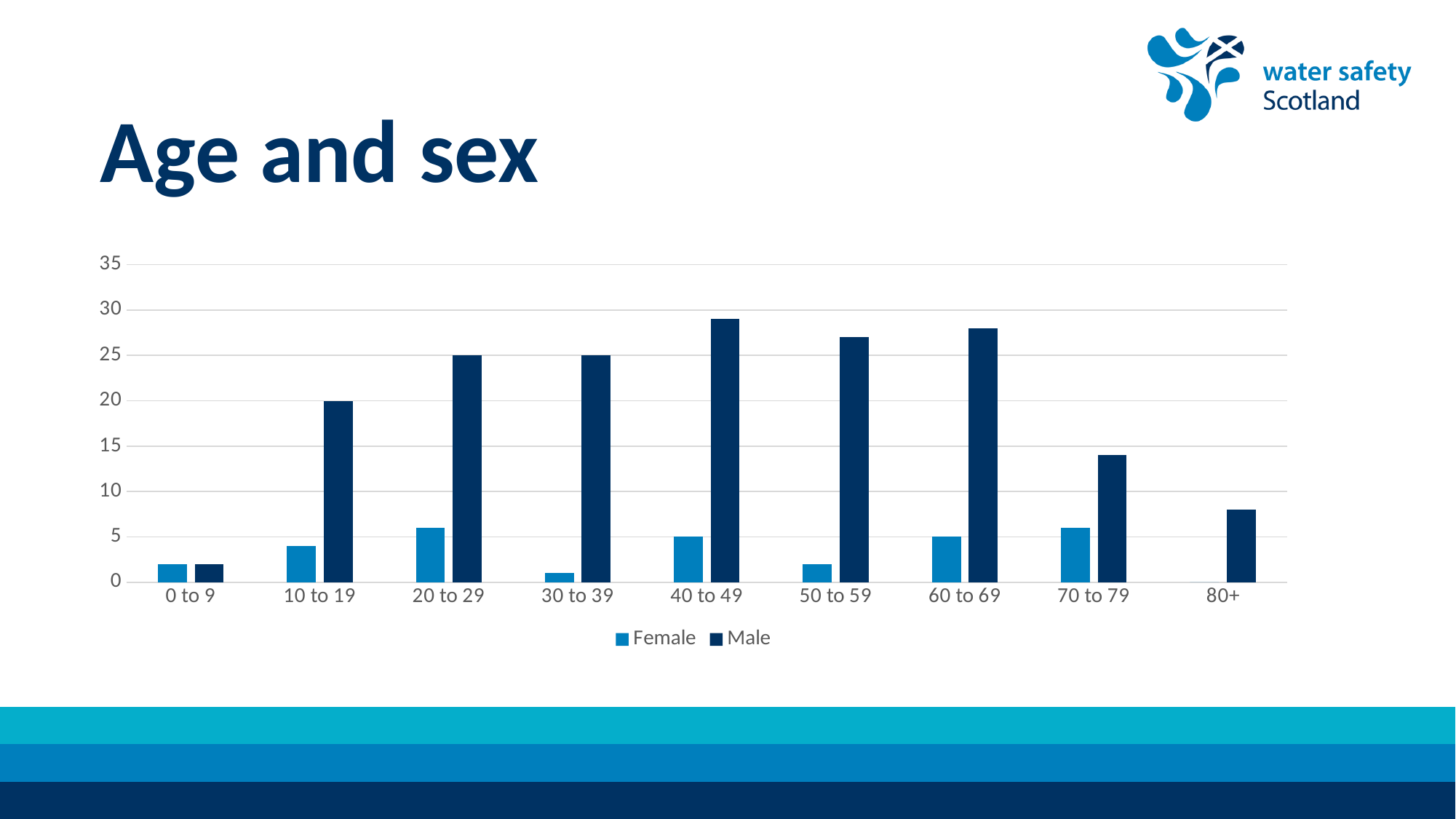
How many series does the legend list? 2 Is the Male value for 70 to 79 greater or less than 15? less Is the Female value for 0 to 9 greater or less than 5? less What is the Male value for the 10 to 19 age group? 20 Is the Male value for 40 to 49 greater or less than 25? greater In the 40 to 49 age group, which is larger, the Female or the Male value? Male What is the Male value for the 20 to 29 age group? 25 Do the Male values rise or fall from the 60 to 69 group to the 80+ group? Fall What is the Female value for the 40 to 49 age group? 5 How many age groups are shown on the x axis? 9 What kind of chart is shown on the slide? Bar chart